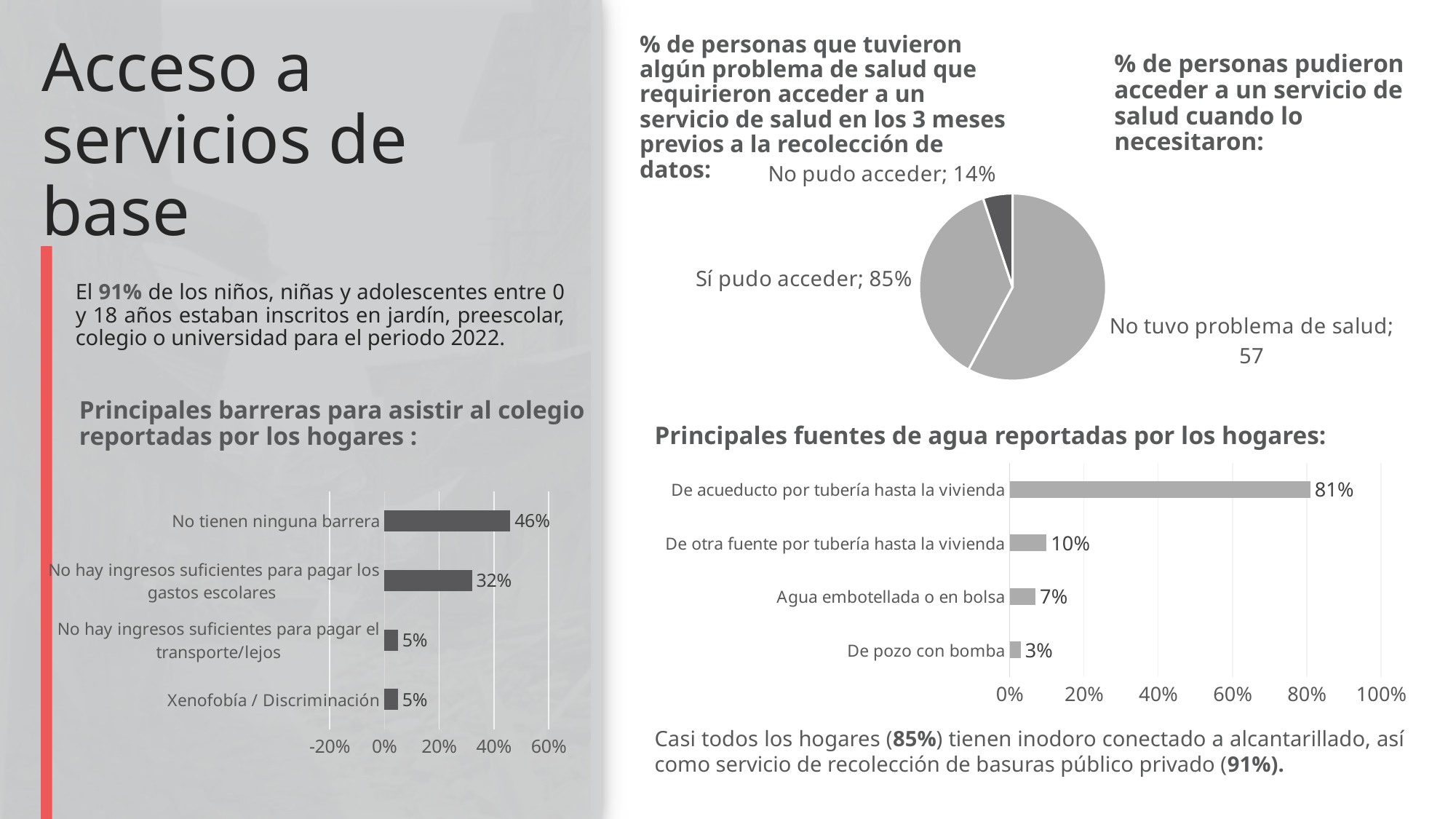
In the chart 'Principales fuentes de agua reportadas por los hogares', which is larger: 'De otra fuente por tubería hasta la vivienda' or 'Agua embotellada o en bolsa'? De otra fuente por tubería hasta la vivienda In the chart 'Principales fuentes de agua reportadas por los hogares', what is the difference between 'De acueducto por tubería hasta la vivienda' and 'De otra fuente por tubería hasta la vivienda'? 71% In the chart 'Principales barreras para asistir al colegio reportadas por los hogares', what is the value for 'No hay ingresos suficientes para pagar los gastos escolares'? 32% In the pie chart about access to a health service, what value is shown for 'No pudo acceder'? 14% How many categories are shown in the chart 'Principales barreras para asistir al colegio reportadas por los hogares'? 4 In the chart 'Principales barreras para asistir al colegio reportadas por los hogares', what is the value for 'No tienen ninguna barrera'? 46% In the pie chart about access to a health service, what value is shown for 'Sí pudo acceder'? 85% In the chart 'Principales barreras para asistir al colegio reportadas por los hogares', what is the difference between 'No tienen ninguna barrera' and 'No hay ingresos suficientes para pagar los gastos escolares'? 14% In the chart 'Principales fuentes de agua reportadas por los hogares', what is the value for 'De acueducto por tubería hasta la vivienda'? 81% What kind of chart is 'Principales fuentes de agua reportadas por los hogares'? Bar chart In the chart 'Principales fuentes de agua reportadas por los hogares', which category has the lowest value? De pozo con bomba In the chart 'Principales barreras para asistir al colegio reportadas por los hogares', which category has the highest value? No tienen ninguna barrera